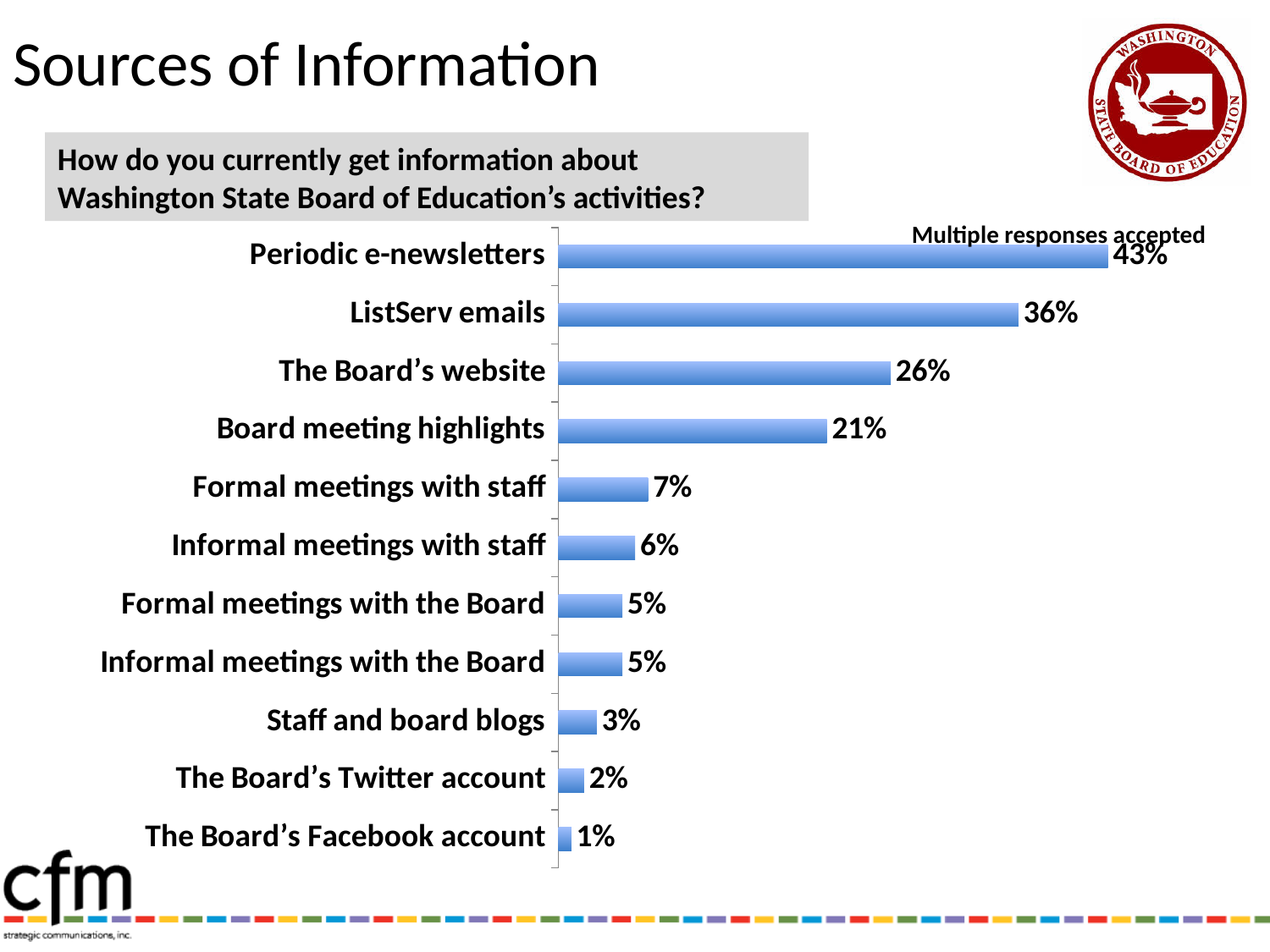
What is the difference between the percentages for Periodic e-newsletters and ListServ emails? 7% What is the difference between the values for The Board's website and Board meeting highlights? 5% What note appears above the chart about how responses were collected? Multiple responses accepted What is the value for ListServ emails? 36% What kind of chart is shown on the slide? Bar chart What percentage is shown for Board meeting highlights? 21% Which is larger, the value for Formal meetings with staff or Informal meetings with staff? Formal meetings with staff What percentage of respondents get information through periodic e-newsletters? 43% Which source of information has the highest percentage? Periodic e-newsletters How many sources of information are shown in the chart? 11 Which source of information has the lowest percentage? The Board's Facebook account Which is larger, the value for Staff and board blogs or The Board's Twitter account? Staff and board blogs